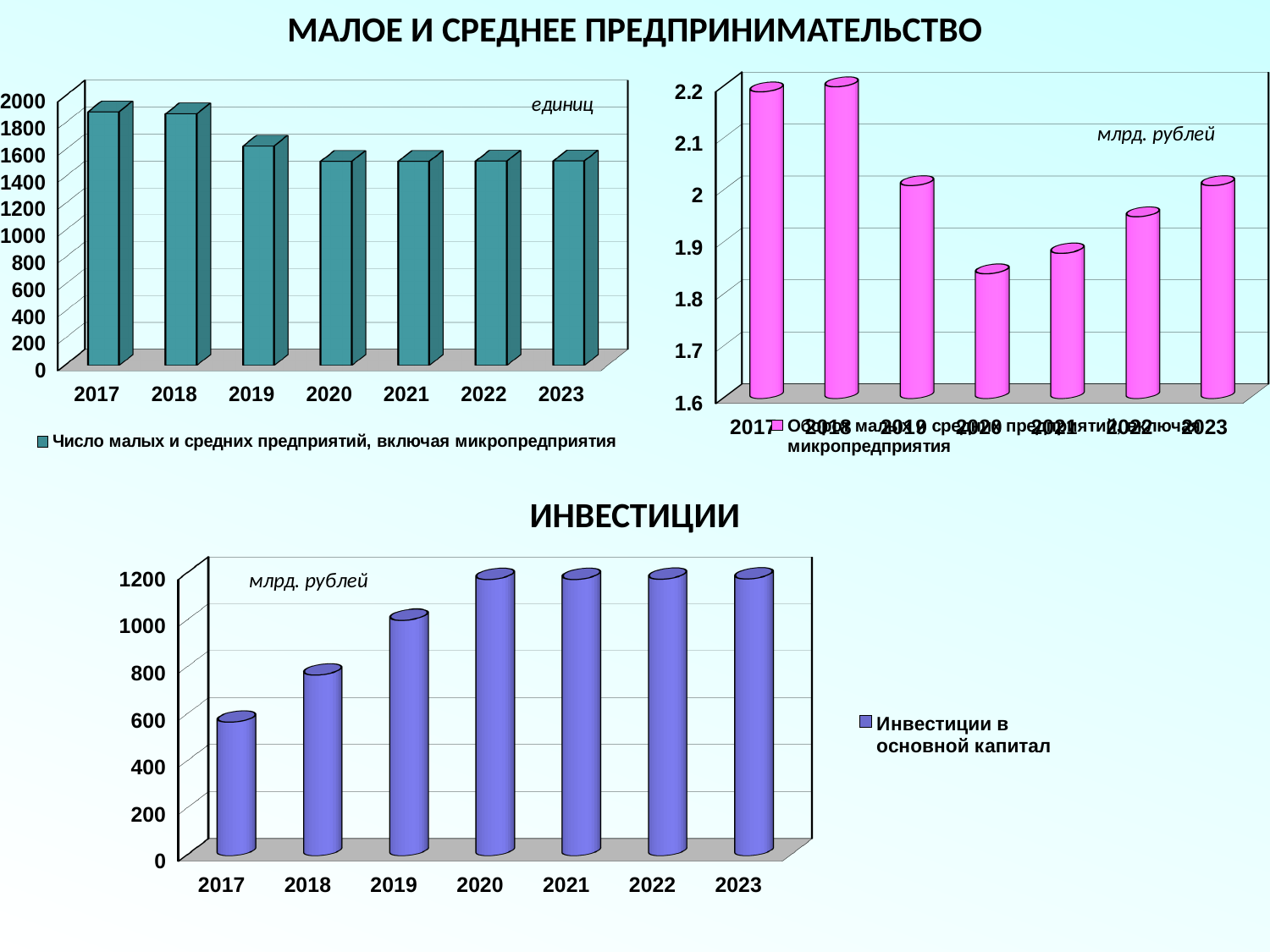
How many series does the legend of the bottom chart list? 1 In the bottom chart, is the value for 2018 greater or less than 800? less In the top-left chart, is the value for 2017 greater or less than 1800? greater What kind of chart is the bottom chart titled ИНВЕСТИЦИИ? bar chart How many years are shown on the x axis of the top-left chart? 7 In the top-left chart, is the value for 2020 greater or less than 1600? less In the top-left chart, do the values generally rise or fall from 2017 to 2023? fall In the top-left chart, which is larger, the value for 2017 or the value for 2019? 2017 In the top-right chart, which year has the lowest value? 2020 In the bottom chart, which year has the lowest value? 2017